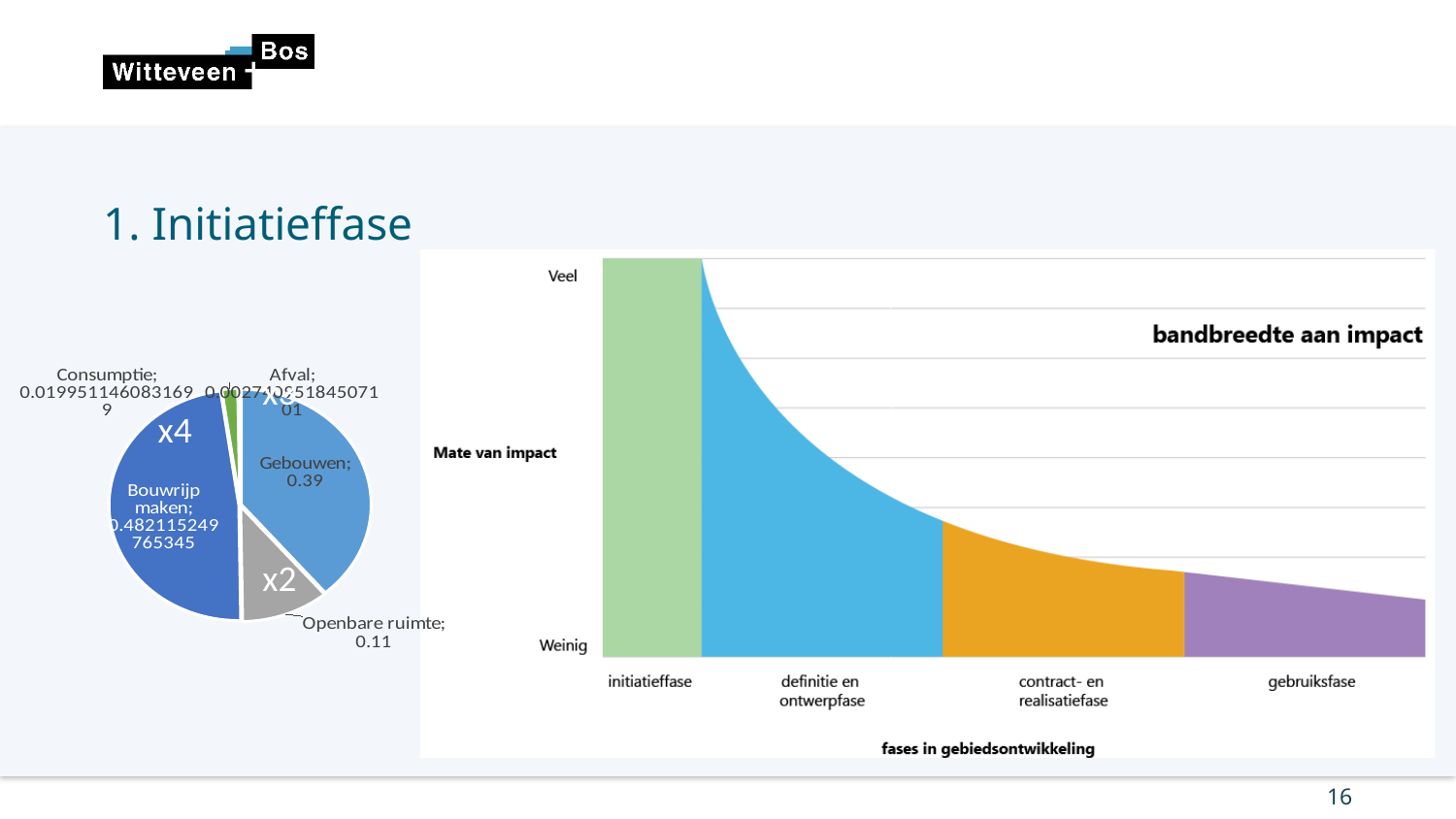
In the pie chart on the left, what is the value for Gebouwen? 0.39 In the chart on the right, how many phases are shown along the x axis? 4 What is the x-axis title of the chart on the right? fases in gebiedsontwikkeling In the pie chart on the left, which category has the largest slice? Bouwrijp maken In the pie chart on the left, what is the value for Bouwrijp maken? 0.482115249765345 In the pie chart on the left, what is the difference between the values for Gebouwen and Openbare ruimte? 0.28 What kind of chart is shown on the left of the slide? Pie chart In the pie chart on the left, which is larger: Gebouwen or Openbare ruimte? Gebouwen In the chart on the right, does the level of impact rise or fall from initiatieffase to gebruiksfase? Fall How many slices does the pie chart on the left have? 5 In the pie chart on the left, which category has the smallest slice? Afval In the pie chart on the left, what is the value for Openbare ruimte? 0.11